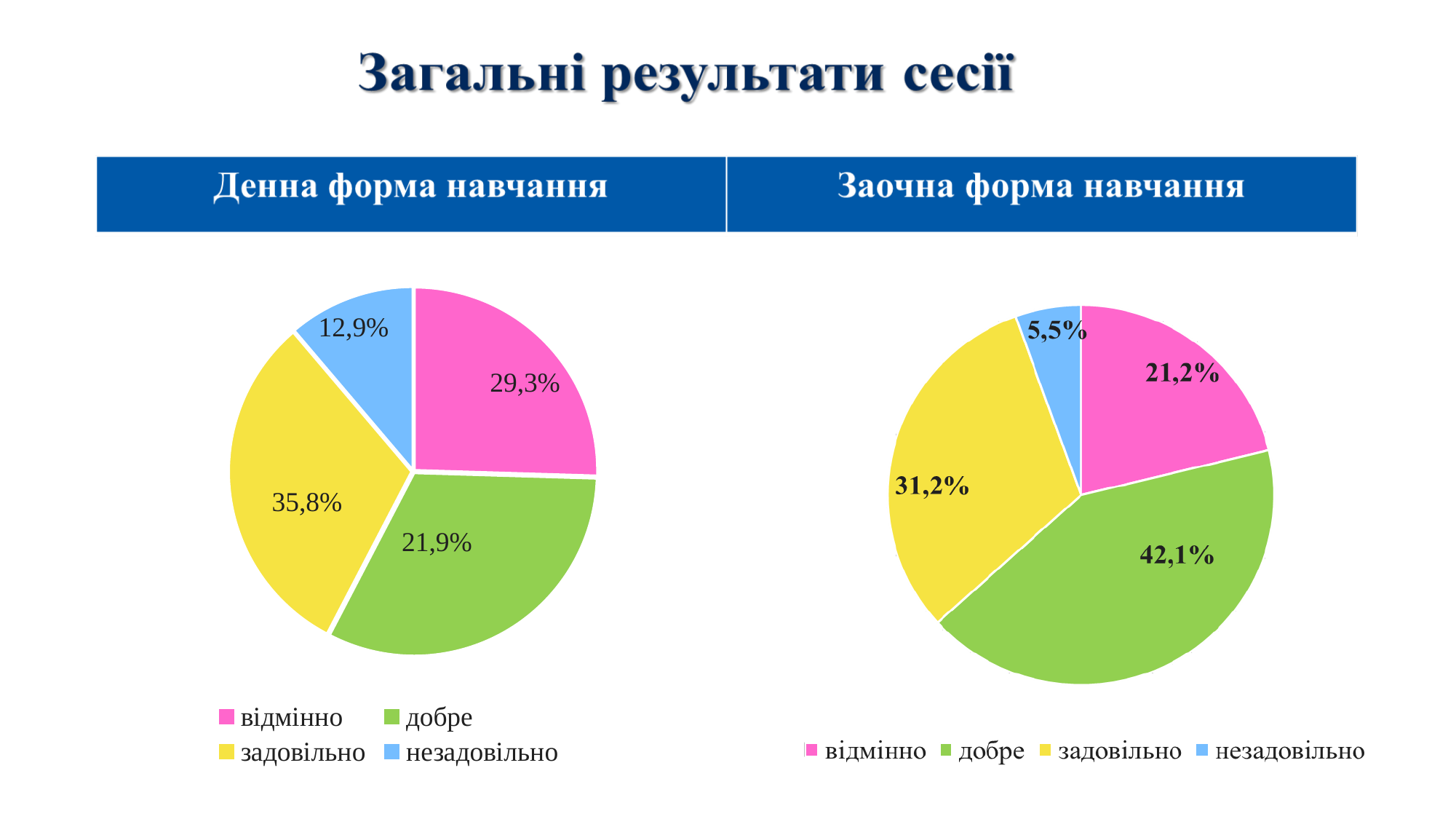
How many slices does the "Денна форма навчання" pie chart have? 4 In the "Денна форма навчання" pie chart, what is the difference between the задовільно and добре shares? 13,9% In the "Заочна форма навчання" pie chart, which category has the smallest slice? незадовільно In the "Заочна форма навчання" pie chart, which category has the largest slice? добре In the "Заочна форма навчання" pie chart, what share is labelled for задовільно? 31,2% Which chart has the larger share for добре: "Денна форма навчання" or "Заочна форма навчання"? Заочна форма навчання In the "Денна форма навчання" pie chart, which category has the largest slice? задовільно In the "Денна форма навчання" pie chart, what share is labelled for незадовільно? 12,9% In the "Заочна форма навчання" pie chart, what share is labelled for добре? 42,1% In the "Заочна форма навчання" pie chart, what is the difference between the добре and відмінно shares? 20,9% In the "Денна форма навчання" pie chart, what share is labelled for відмінно? 29,3% What type of chart is used under "Заочна форма навчання"? Pie chart